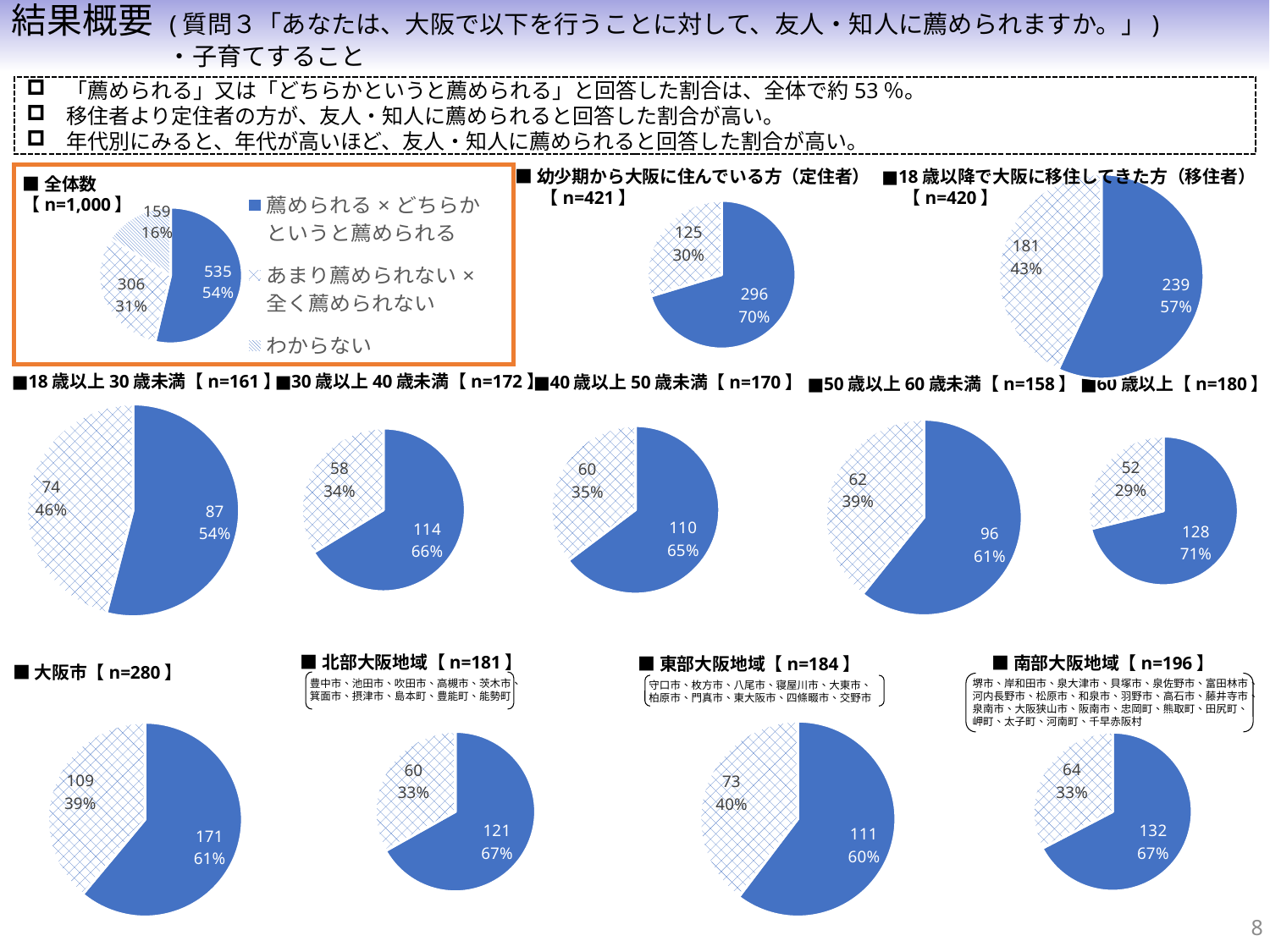
Which is larger: the solid blue slice percentage in the 定住者 (n=421) pie chart or in the 移住者 (n=420) pie chart? 定住者 (n=421) Among the five age-group pie charts, which group has the lowest percentage for the solid blue slice? 18歳以上30歳未満 In the 全体数 (n=1,000) pie chart, what percentage is shown for わからない? 16% How many entries does the legend next to the 全体数 pie chart list? 3 Among the five age-group pie charts (18歳以上30歳未満 to 60歳以上), which group has the highest percentage for the solid blue slice? 60歳以上 In the 全体数 (n=1,000) pie chart, how many slices does the pie have? 3 In the 大阪市 (n=280) pie chart, what is the value shown for the solid blue slice? 171 What type of chart is used for the 幼少期から大阪に住んでいる方（定住者） (n=421) data? Pie chart What is the difference between the solid blue slice values in the 30歳以上40歳未満 (n=172) pie chart and the 18歳以上30歳未満 (n=161) pie chart? 27 In the 全体数 (n=1,000) pie chart, what is the value shown for 薦められる × どちらかというと薦められる? 535 In the 18歳以降で大阪に移住してきた方（移住者） (n=420) pie chart, what is the value shown for the smaller (hatched) slice? 181 In the 幼少期から大阪に住んでいる方（定住者） (n=421) pie chart, what percentage is shown for the larger (solid blue) slice? 70%